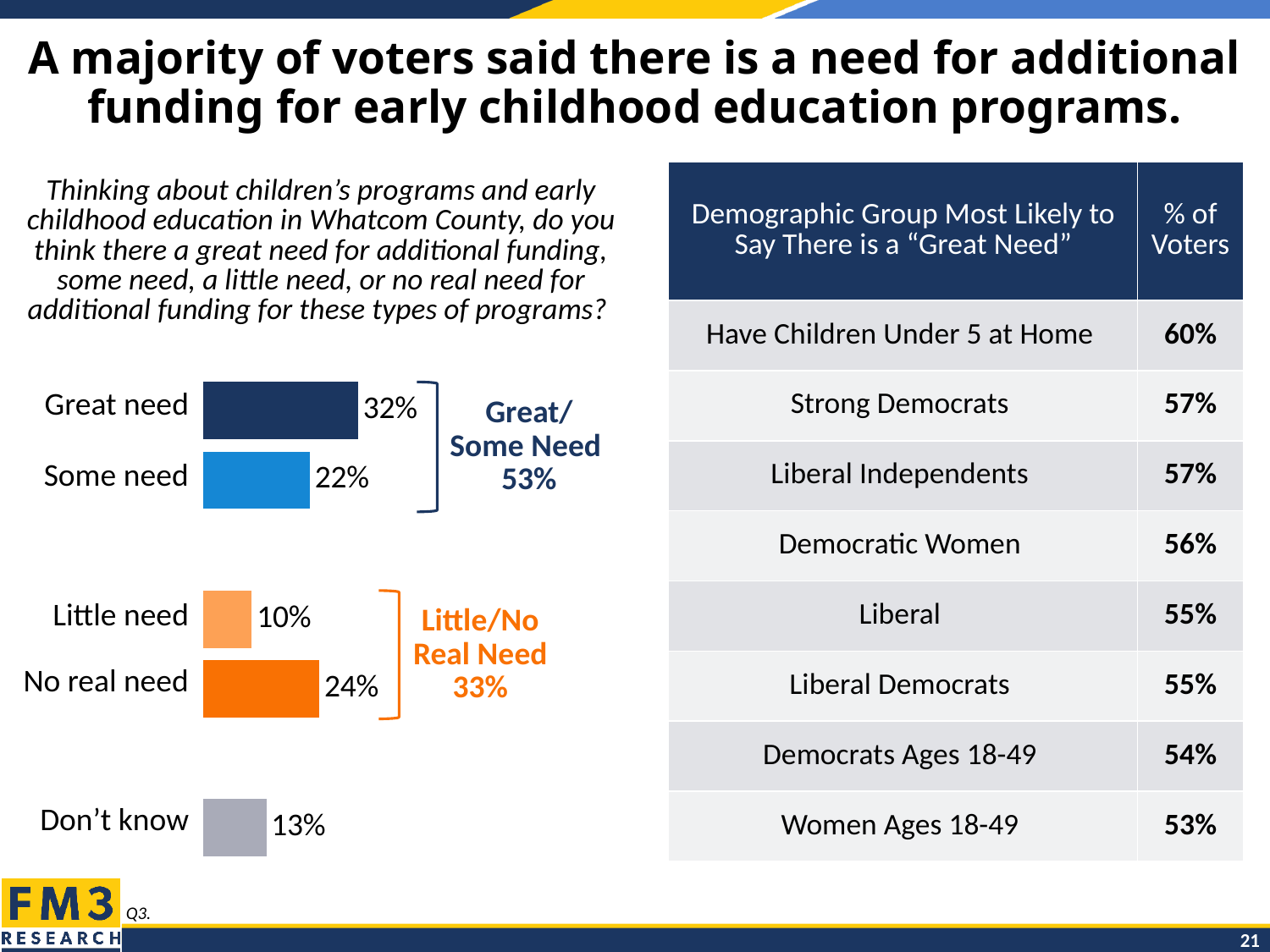
Which response category has the highest percentage in the bar chart? Great need What percentage of voters said there is a great need for additional funding? 32% What percentage of voters said there is a little need? 10% What percentage of voters answered 'Don't know'? 13% Which response category has the lowest percentage in the bar chart? Little need What percentage of voters said there is no real need? 24% What percentage of voters said there is some need for additional funding? 22% Which is larger, the percentage for 'No real need' or the percentage for 'Some need'? No real need How many response categories are shown in the bar chart? 5 What type of chart is used to show the survey responses? Bar chart What combined percentage is shown for 'Great/Some Need' next to the bar chart? 53% What is the difference in percentage points between 'Great need' and 'Some need'? 10